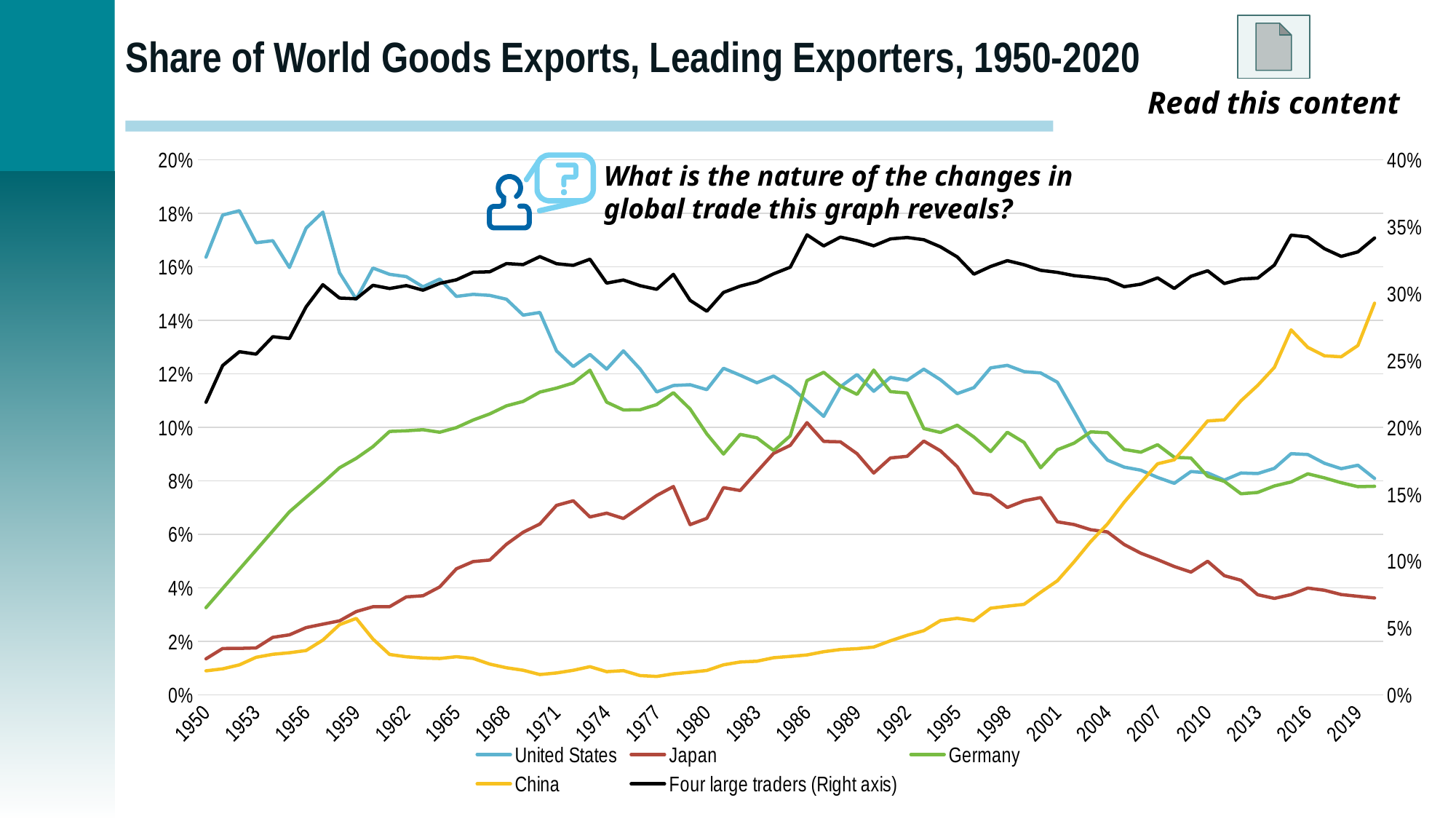
Does the China line rise or fall overall from 1950 to 2020? Rises Is the value for the United States in 1950 greater or less than 14%? greater Does the United States line rise or fall overall from 1950 to 2020? Falls Among the left-axis series, which has the lowest value in 2020? Japan What is the title of the chart? Share of World Goods Exports, Leading Exporters, 1950-2020 How many series does the legend list? 5 In 2019, which is higher, China or Germany? China Which series is plotted against the right axis? Four large traders What kind of chart is shown on the slide? Line chart Is the value for China in 2019 greater or less than 12%? greater Does the Japan line rise or fall from 1995 to 2020? Falls Is the value for Japan in 1950 greater or less than 4%? less